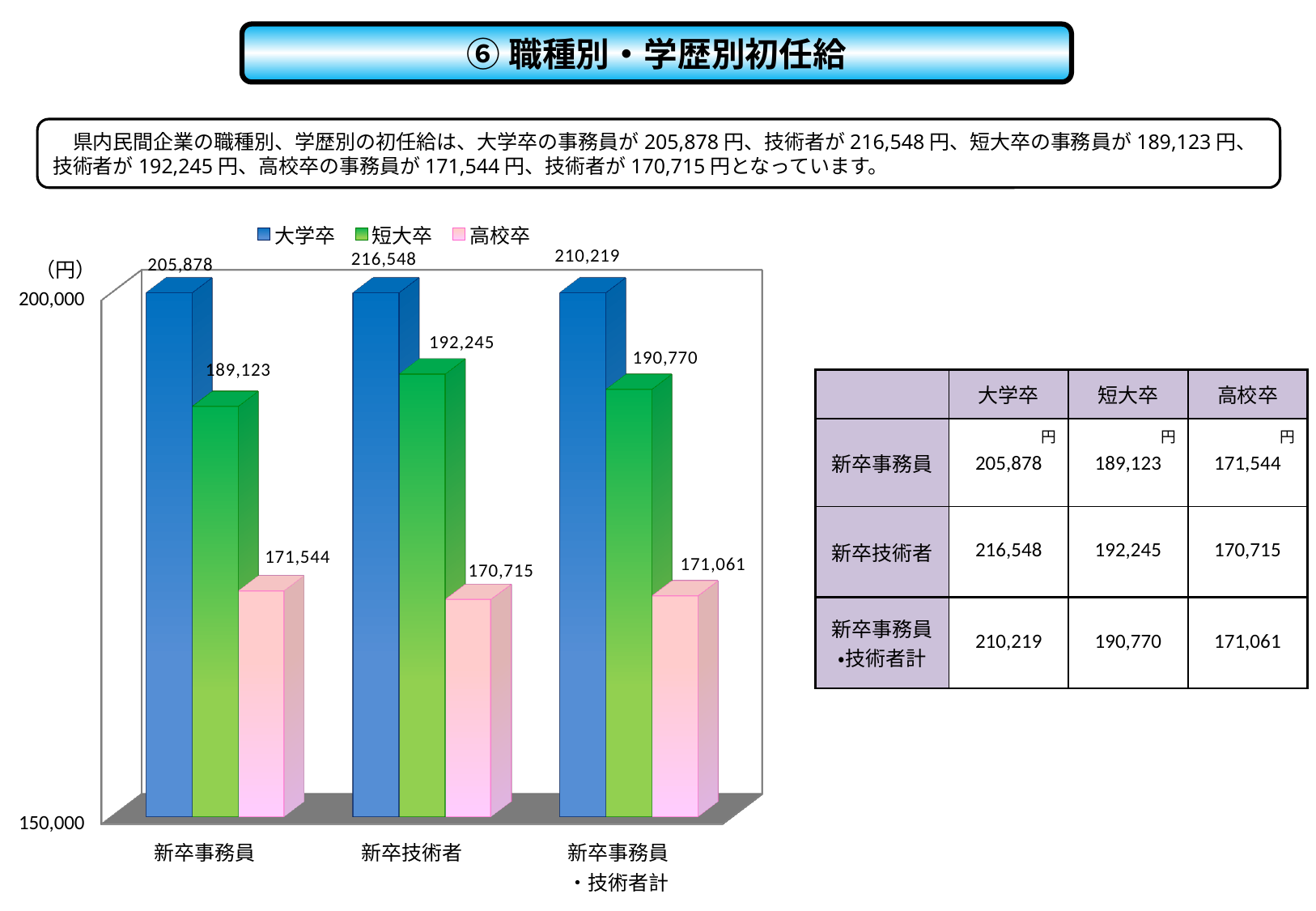
Which category has the highest 大学卒 value? 新卒技術者 What is the value for 高校卒 in the 新卒事務員・技術者計 category? 171,061 How many series does the legend list? 3 How many categories are shown on the x axis? 3 Which is larger, the 高校卒 value for 新卒事務員 or for 新卒技術者? 新卒事務員 What is the difference between the 大学卒 values for 新卒技術者 and 新卒事務員? 10,670 What is the value for 大学卒 in the 新卒事務員 category? 205,878 What is the value for 短大卒 in the 新卒技術者 category? 192,245 What is the difference between the 大学卒 and 高校卒 values for 新卒事務員? 34,334 What kind of chart is shown on the slide? bar chart Which category has the lowest 短大卒 value? 新卒事務員 Which series is shown in green in the legend? 短大卒